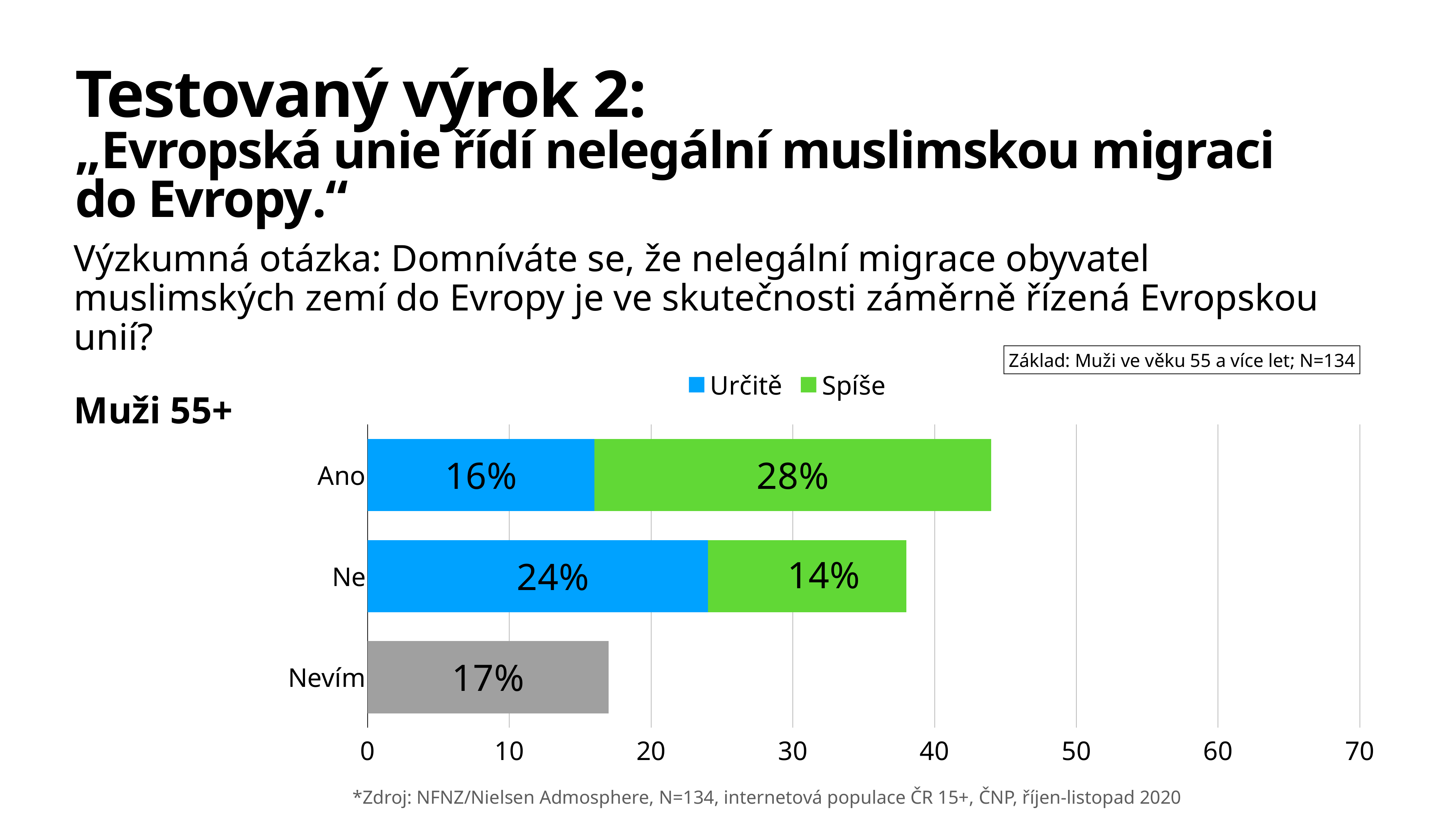
How many categories are shown on the y axis of the chart? 3 How many series does the legend list? 2 What is the value of the Spíše series for the Ne category? 14% What is the difference between the Určitě values for Ne and Ano? 8% What kind of chart is shown on the slide? Bar chart What is the total of the stacked bar for the Ano category? 44% Which is larger: the Spíše value for Ano or the Spíše value for Ne? Ano Which category has the lowest Určitě value? Ano Which category has the highest Spíše value? Ano What is the total of the stacked bar for the Ne category? 38% What is the value of the Určitě series for the Ano category? 16% What is the value shown for the Nevím category? 17%